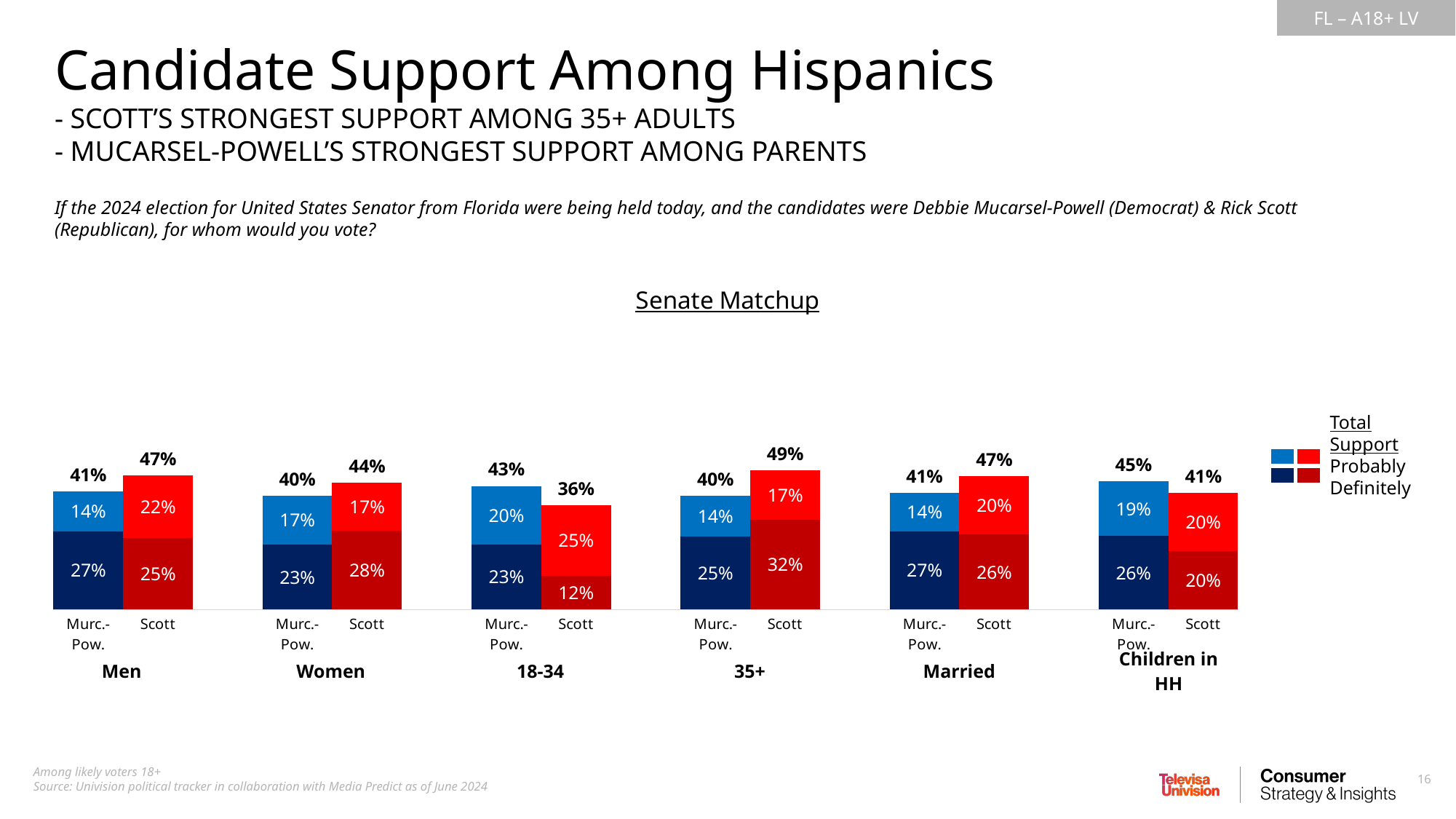
Among Men, how many percentage points higher is Scott's total support than Murc.-Pow.'s? 6 percentage points What is the title of the chart? Senate Matchup What kind of chart is the Senate Matchup chart? Stacked bar chart What is the total support for Murc.-Pow. among Married voters? 41% What is the total support for Scott among 35+ adults? 49% Among voters with Children in HH, which candidate has the higher total support? Murc.-Pow. What share of Women say they would definitely vote for Murc.-Pow.? 23% How many demographic groups are shown in the Senate Matchup chart? 6 In which demographic group does Scott have the lowest total support? 18-34 In which demographic group does Scott have the highest total support? 35+ What is the 'Probably' share for Scott among 18-34 year olds? 25% How many support levels does the legend list? 2